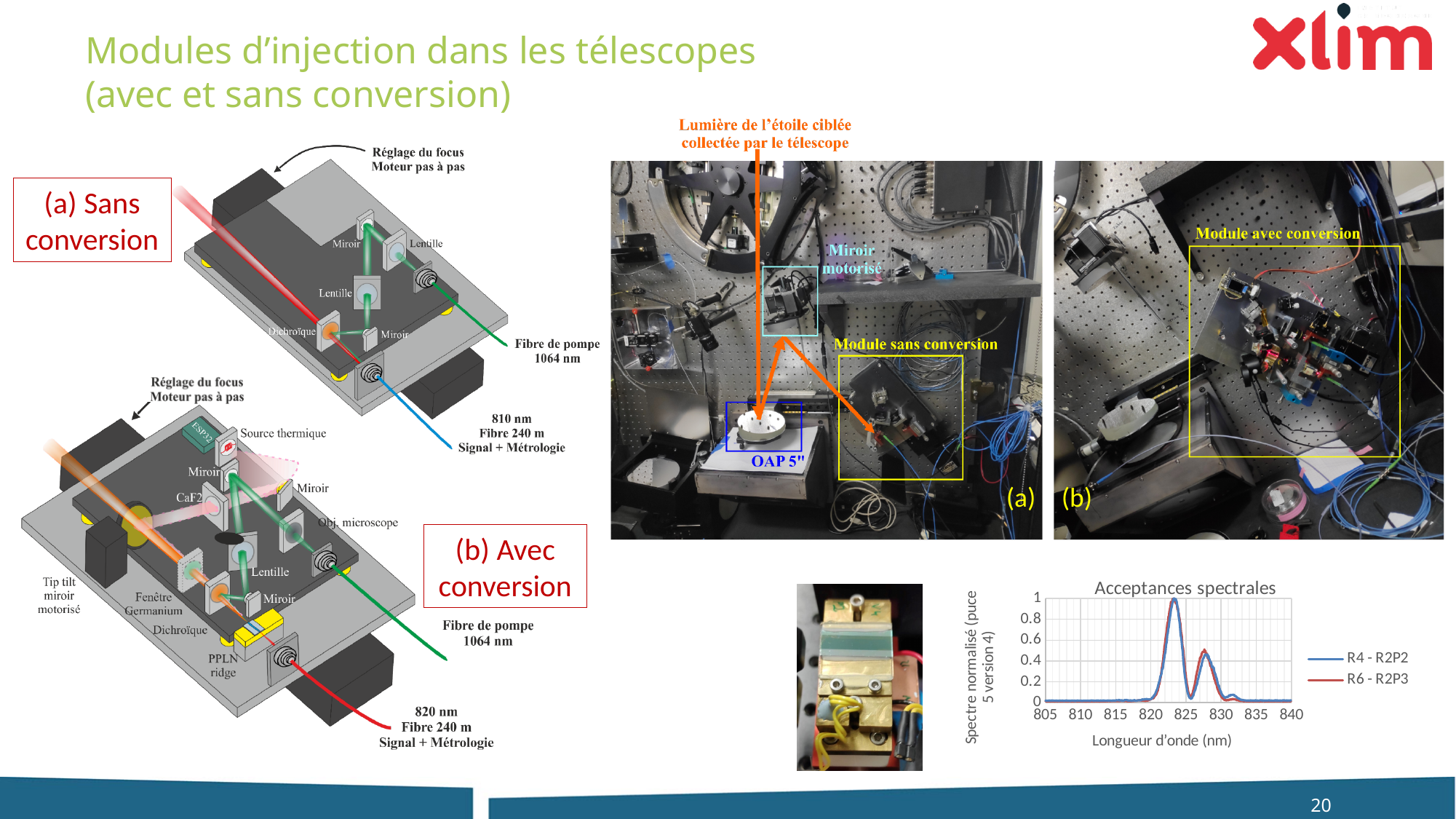
What is the highest wavelength tick shown on the x axis of the 'Acceptances spectrales' chart? 840 In the 'Acceptances spectrales' chart, is the value of R4 - R2P2 at 840 nm greater or less than 0.2? less In the 'Acceptances spectrales' chart, is the second (smaller) peak of the R6 - R2P3 series, near 828 nm, greater or less than 0.8? less In the 'Acceptances spectrales' chart, is the peak value of the R4 - R2P2 series greater or less than 0.8? greater What is the maximum value shown on the y axis of the 'Acceptances spectrales' chart? 1 What is the x-axis label of the 'Acceptances spectrales' chart? Longueur d'onde (nm) What kind of chart is 'Acceptances spectrales'? line chart What are the two series named in the legend of the 'Acceptances spectrales' chart? R4 - R2P2 and R6 - R2P3 How many series does the legend of the 'Acceptances spectrales' chart list? 2 What is the lowest wavelength tick shown on the x axis of the 'Acceptances spectrales' chart? 805